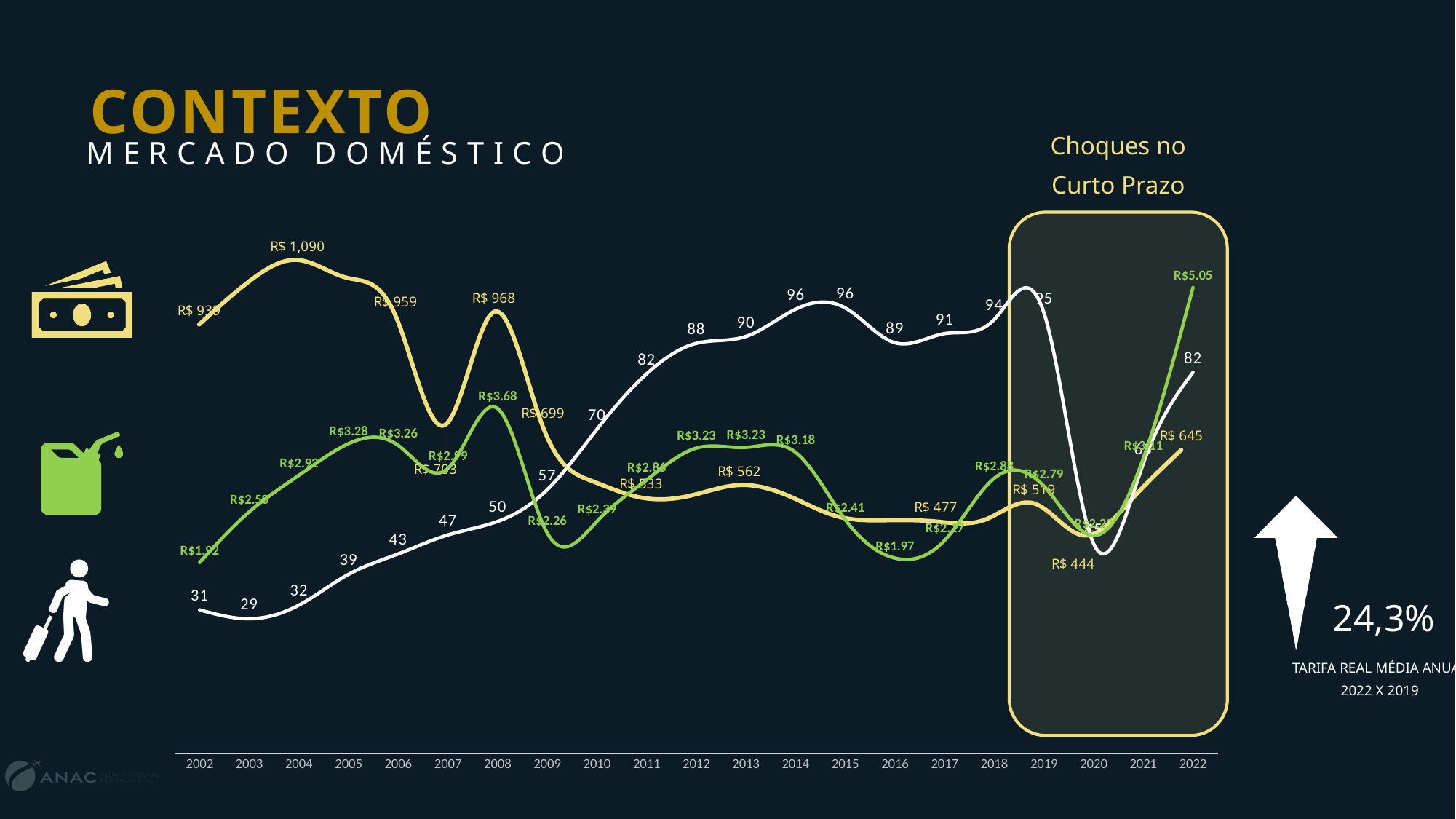
What is the lowest value shown on the yellow line? R$ 444 How many years are shown on the x axis of the chart? 21 Does the white line rise or fall between 2003 and 2014? rise Which year has the larger value on the white line, 2009 or 2010? 2010 In which year does the yellow line reach its highest value? 2004 What is the difference between the white line's value in 2022 and its value in 2002? 51 What kind of chart is shown on the slide? line chart What is the highest value shown on the green line? R$5.05 What is the value of the white line in 2010? 70 What is the value of the yellow line in 2013? R$ 562 What is the value of the green line in 2008? R$3.68 What label appears above the highlighted box covering 2019 to 2022? Choques no Curto Prazo